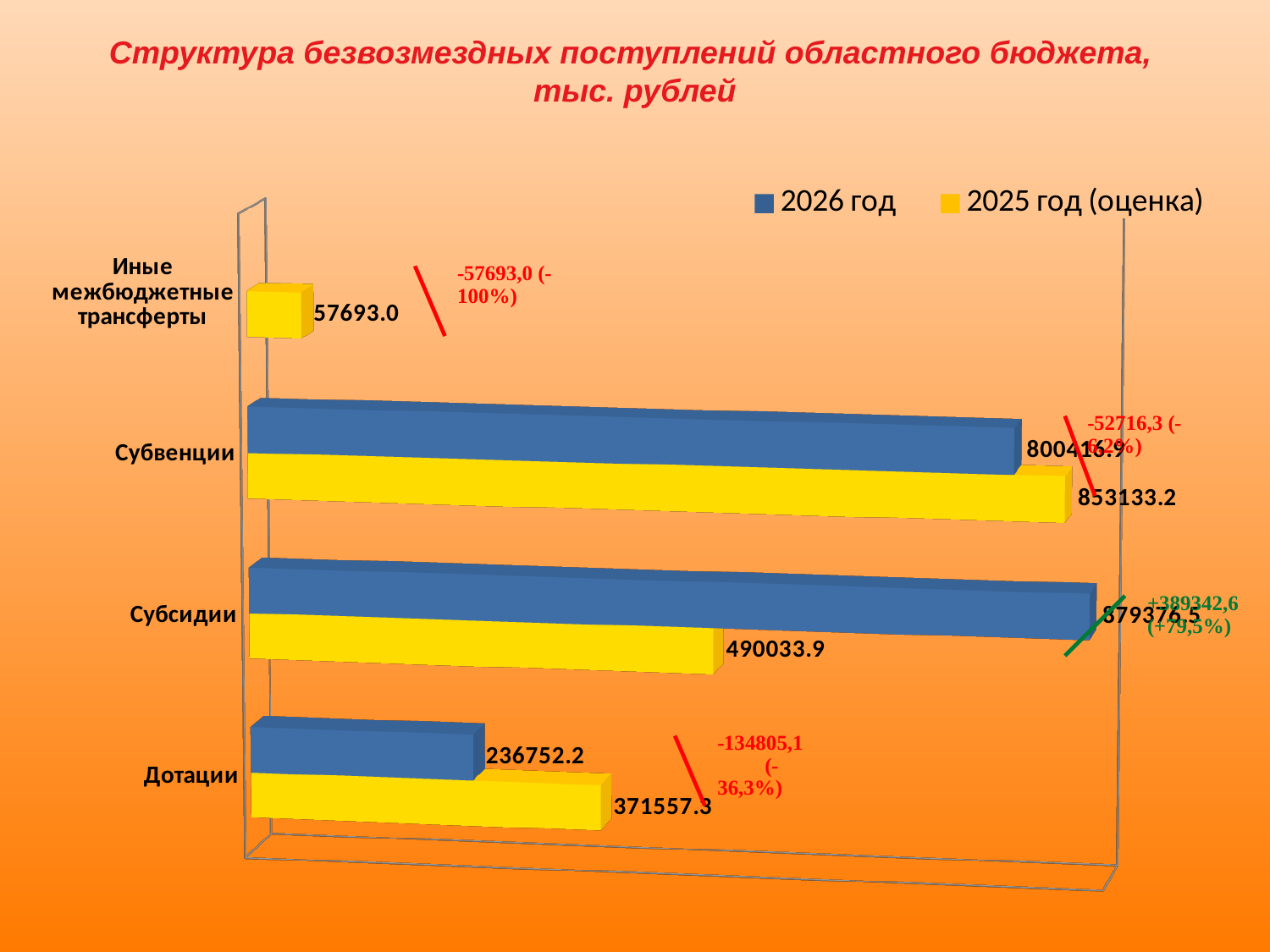
What is the value for Иные межбюджетные трансферты in the 2025 год (оценка) series? 57693.0 For Субсидии, which series has the larger value, 2026 год or 2025 год (оценка)? 2026 год How many categories are shown on the chart? 4 What kind of chart is shown on the slide? bar chart What is the difference between the 2025 год (оценка) and 2026 год values for Дотации? 134805.1 What is the value for Дотации in the 2026 год series? 236752.2 Which category has the highest value in the 2025 год (оценка) series? Субвенции Which category has the lowest value in the 2025 год (оценка) series? Иные межбюджетные трансферты What is the value for Субсидии in the 2025 год (оценка) series? 490033.9 What is the value for Дотации in the 2025 год (оценка) series? 371557.3 What is the value for Субвенции in the 2025 год (оценка) series? 853133.2 How many series does the legend list? 2